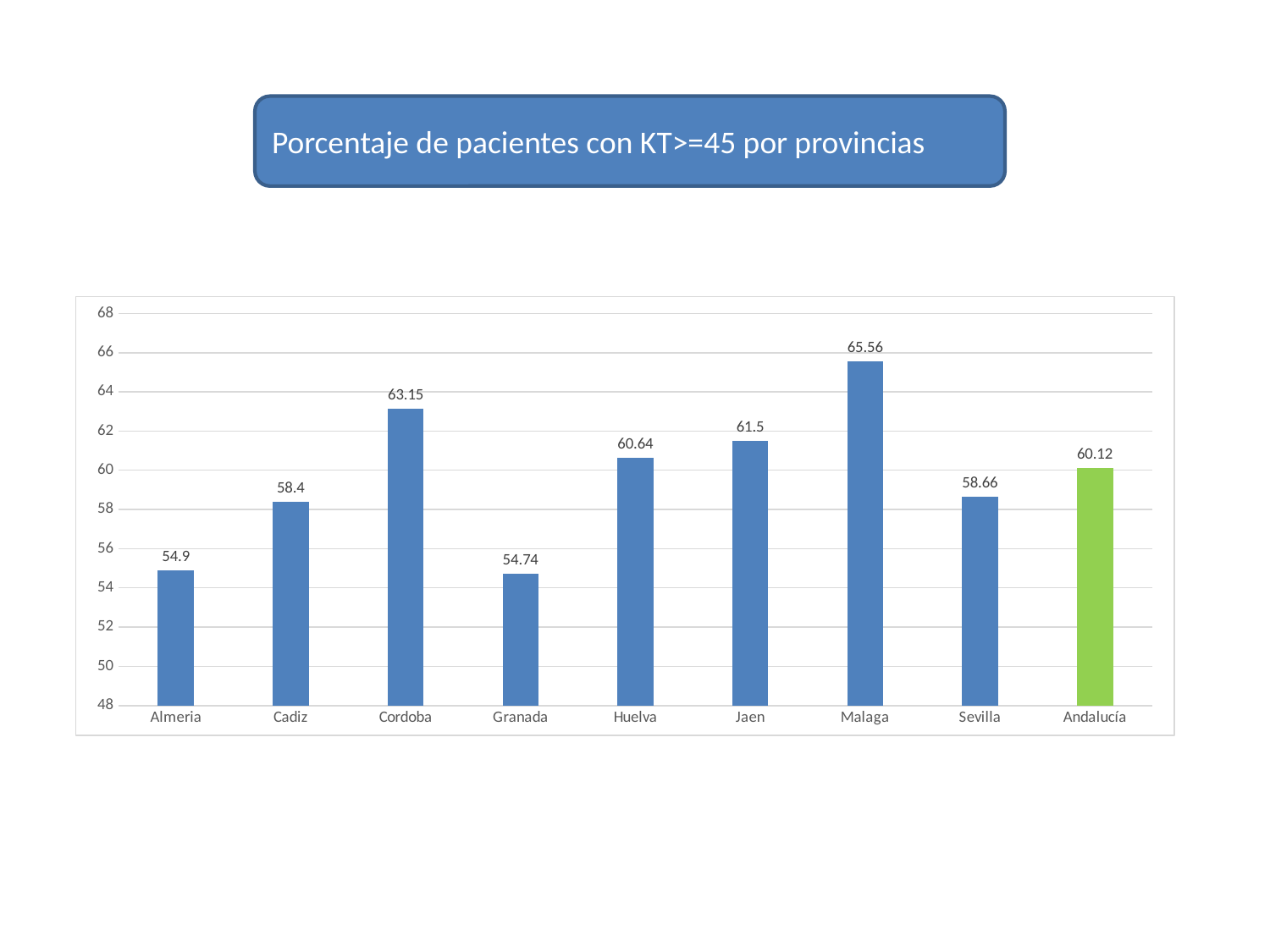
Which category has the lowest value? Granada Which is larger, the value for Huelva or the value for Sevilla? Huelva What kind of chart is shown on the slide? bar chart What is the value for Granada? 54.74 Which province has the highest value? Malaga What is the difference between the values for Cordoba and Cadiz? 4.75 What is the value for Malaga? 65.56 How many categories are shown on the x axis? 9 What is the difference between the values for Malaga and Granada? 10.82 Is the value for Jaen greater or less than 60? greater Which bar is coloured green instead of blue? Andalucía What is the value for Andalucía? 60.12